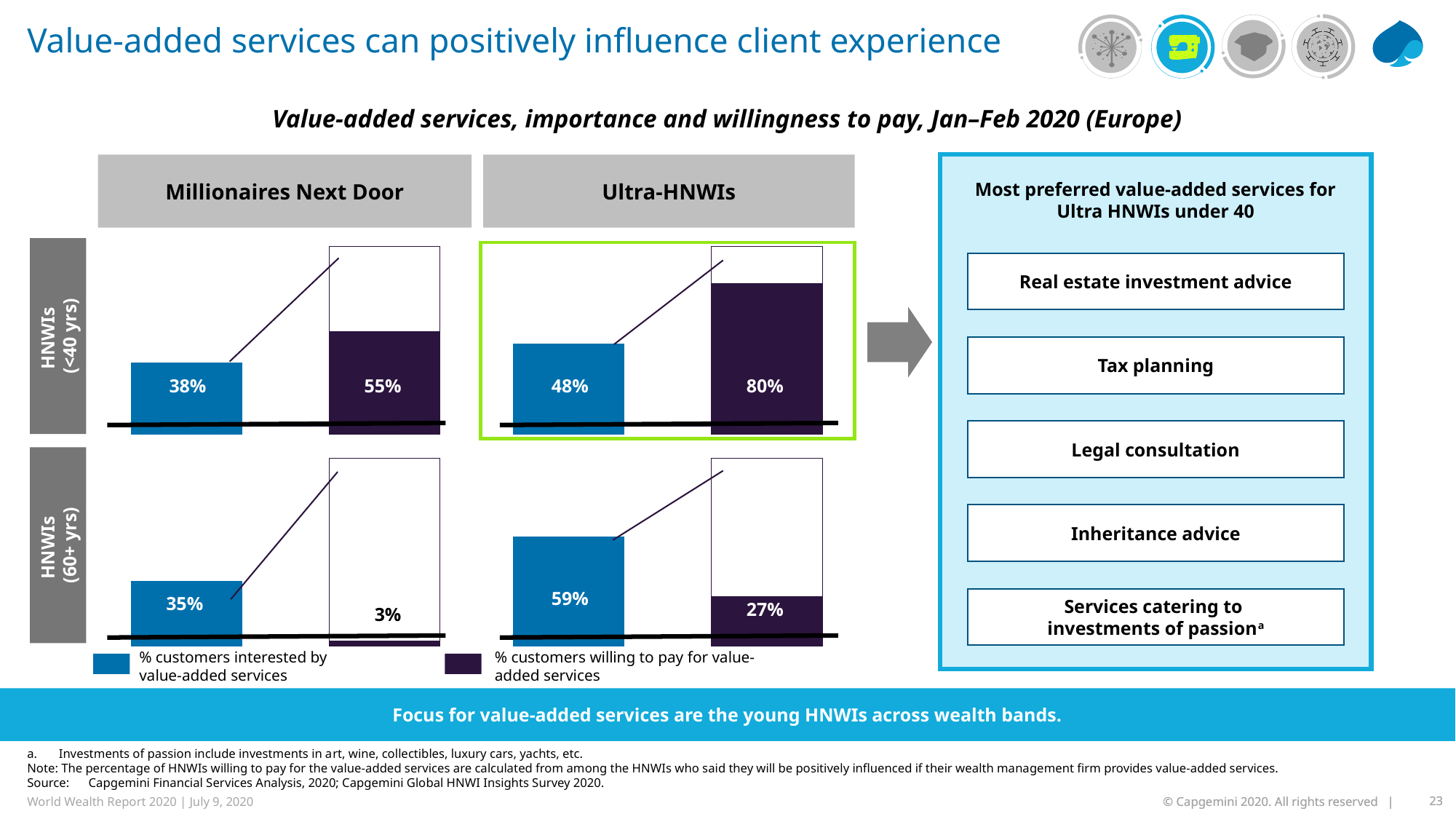
In the Ultra-HNWIs chart for HNWIs under 40 years, what percentage of customers are willing to pay for value-added services? 80% What kind of chart is used to show the value-added services data? Bar chart How many series does the legend list for the charts? 2 In the Ultra-HNWIs chart for HNWIs aged 60+ years, what percentage of customers are interested in value-added services? 59% For HNWIs under 40 years, which group has a higher percentage of customers interested in value-added services, Millionaires Next Door or Ultra-HNWIs? Ultra-HNWIs In the Ultra-HNWIs chart for HNWIs under 40 years, what is the difference between the percentage willing to pay and the percentage interested in value-added services? 32% Across all four charts, which group has the highest percentage of customers willing to pay for value-added services? Ultra-HNWIs under 40 years In the Millionaires Next Door chart for HNWIs aged 60+ years, what percentage of customers are willing to pay for value-added services? 3% In the Millionaires Next Door chart for HNWIs aged 60+ years, what is the difference between the percentage interested and the percentage willing to pay for value-added services? 32% What colour represents the percentage of customers interested in value-added services in the legend? Blue In the Millionaires Next Door chart for HNWIs under 40 years, what percentage of customers are interested in value-added services? 38% Across all four charts, which group has the lowest percentage of customers willing to pay for value-added services? Millionaires Next Door aged 60+ years